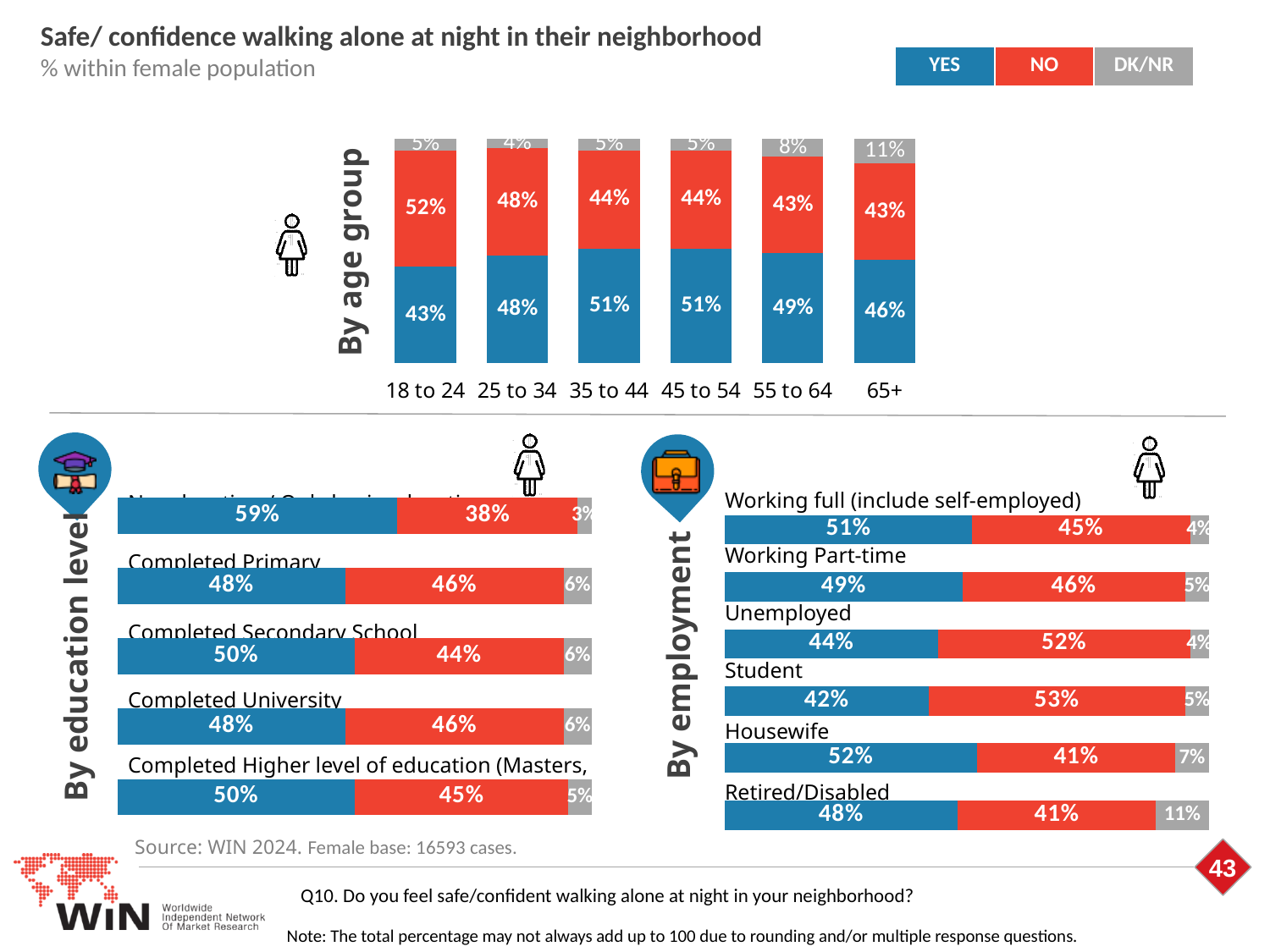
In the 'By age group' chart, which age group has the lowest YES value? 18 to 24 In the 'By age group' chart, which age group has the highest DK/NR value? 65+ In the 'By age group' chart, what is the YES value for the 18 to 24 age group? 43% How many series does the legend list? 3 In the 'By age group' chart, how many age groups are shown? 6 In the 'By education level' chart, what is the DK/NR value for Completed Higher level of education (Masters, ...)? 5% In the 'By employment' chart, which employment category has the highest YES value? Housewife In the 'By employment' chart, what is the NO value for Student? 53% In the 'By age group' chart, what is the difference between the NO value and the YES value for the 18 to 24 age group? 9% In the 'By age group' chart, what is the NO value for the 65+ age group? 43% What kind of chart is the 'By age group' chart? Stacked bar chart In the 'By employment' chart, is the YES value larger for Unemployed or for Working Part-time? Working Part-time